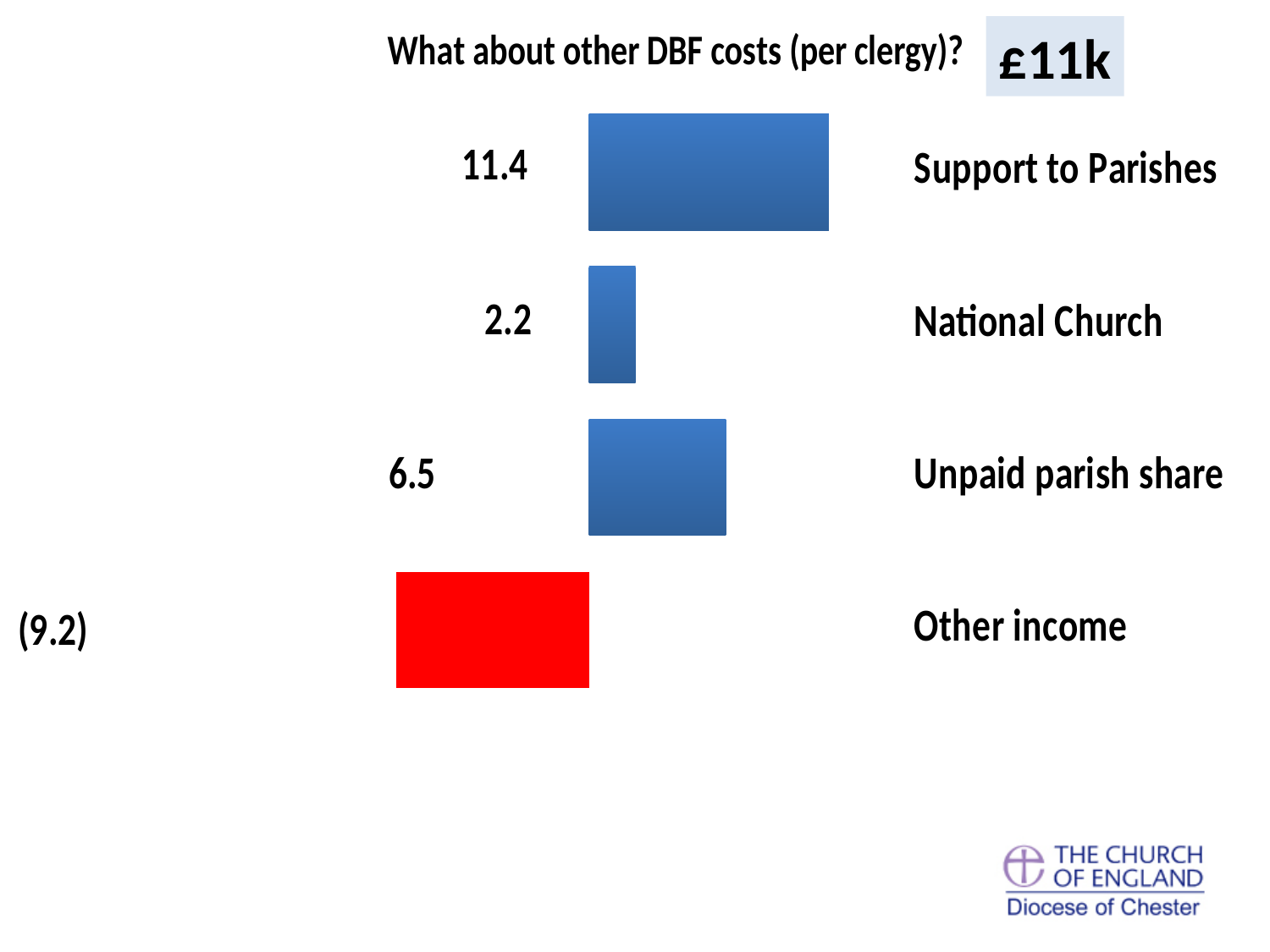
How many categories are shown in the chart? 4 What is the value for Support to Parishes? 11.4 Which is larger, Unpaid parish share or National Church? Unpaid parish share Which category has the lowest value? Other income What is the value shown for Other income? (9.2) What is the difference between Support to Parishes and National Church? 9.2 What kind of chart is shown on the slide? Bar chart Which category's bar is coloured red? Other income What is the difference between Support to Parishes and Unpaid parish share? 4.9 What is the value for Unpaid parish share? 6.5 What is the value for National Church? 2.2 Which category has the highest value? Support to Parishes